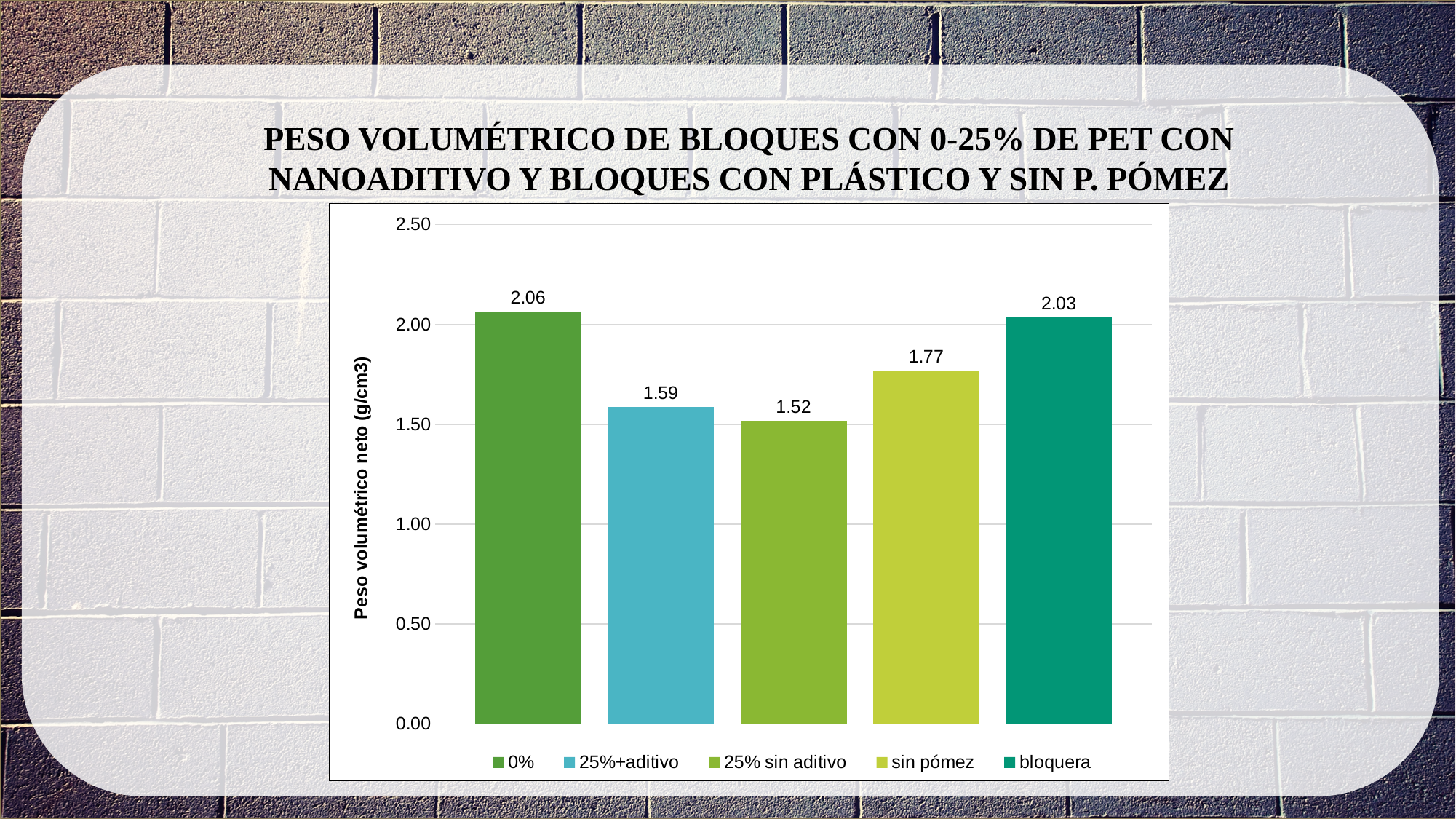
What is the value shown for bloquera? 2.03 What is the value shown for sin pómez? 1.77 What is the difference between the values for 0% and 25% sin aditivo? 0.54 Which is larger, the value for sin pómez or the value for 25%+aditivo? sin pómez What is the value shown for 25%+aditivo? 1.59 What is the label of the vertical axis? Peso volumétrico neto (g/cm3) Which category has the highest net volumetric weight? 0% What is the net volumetric weight for the 0% category? 2.06 Which category has the lowest net volumetric weight? 25% sin aditivo How many bars are plotted in the chart? 5 What is the value shown for 25% sin aditivo? 1.52 What kind of chart is shown on the slide? Bar chart